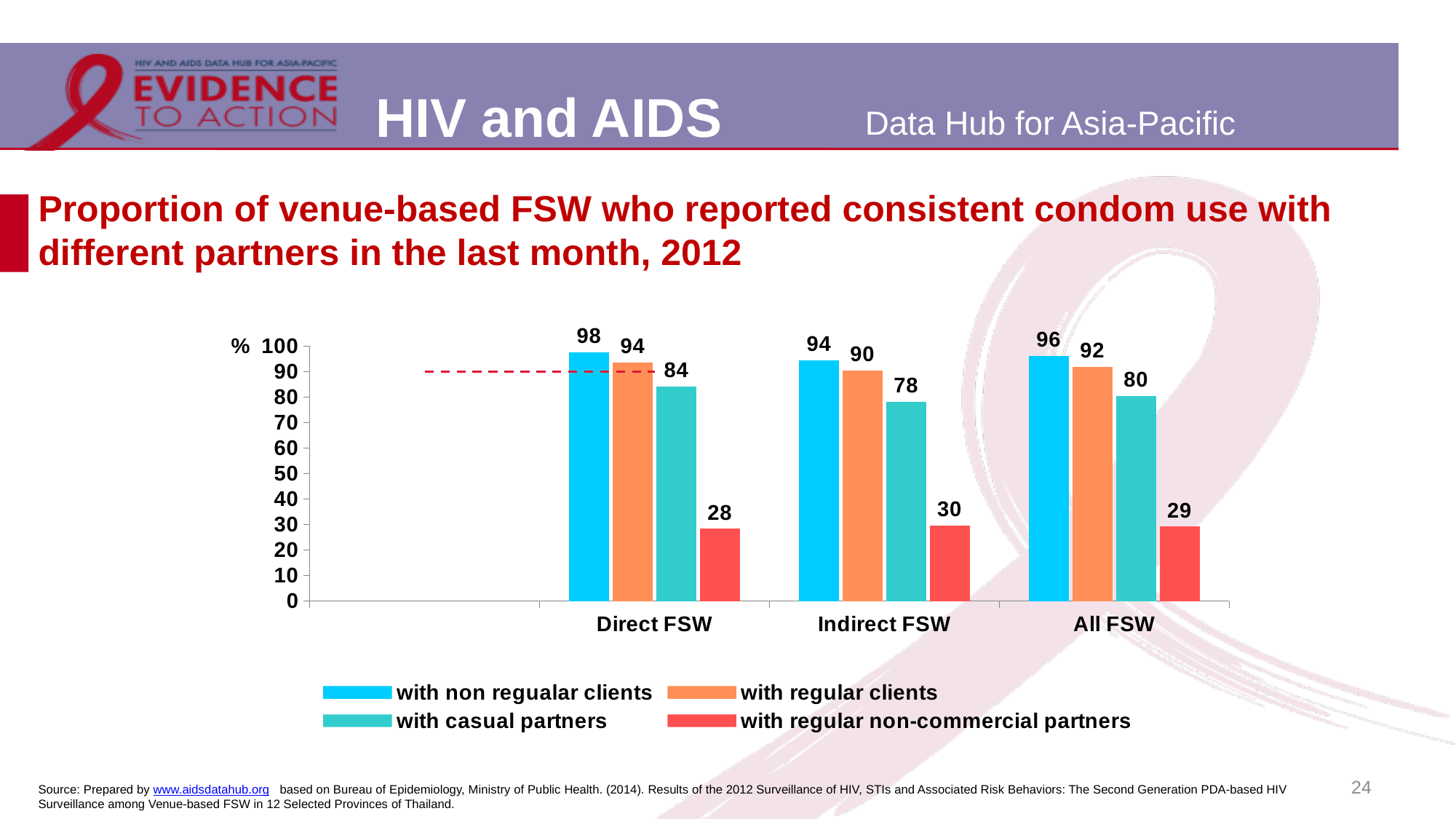
What is the difference between the 'with non regular clients' and 'with regular non-commercial partners' values for Direct FSW? 70 What is the value for Direct FSW with non regular clients? 98 What kind of chart is shown on the slide? bar chart What is the value for All FSW with regular non-commercial partners? 29 What colour are the bars for the 'with regular non-commercial partners' series? red Which category has the lowest value for the 'with regular non-commercial partners' series? Direct FSW What is the difference between the 'with casual partners' values for Direct FSW and Indirect FSW? 6 What is the value for Indirect FSW with casual partners? 78 Which is larger for Indirect FSW: the value with regular clients or the value with casual partners? with regular clients Which category has the highest value for the 'with regular clients' series? Direct FSW How many categories are shown on the x axis? 3 How many series does the legend list? 4